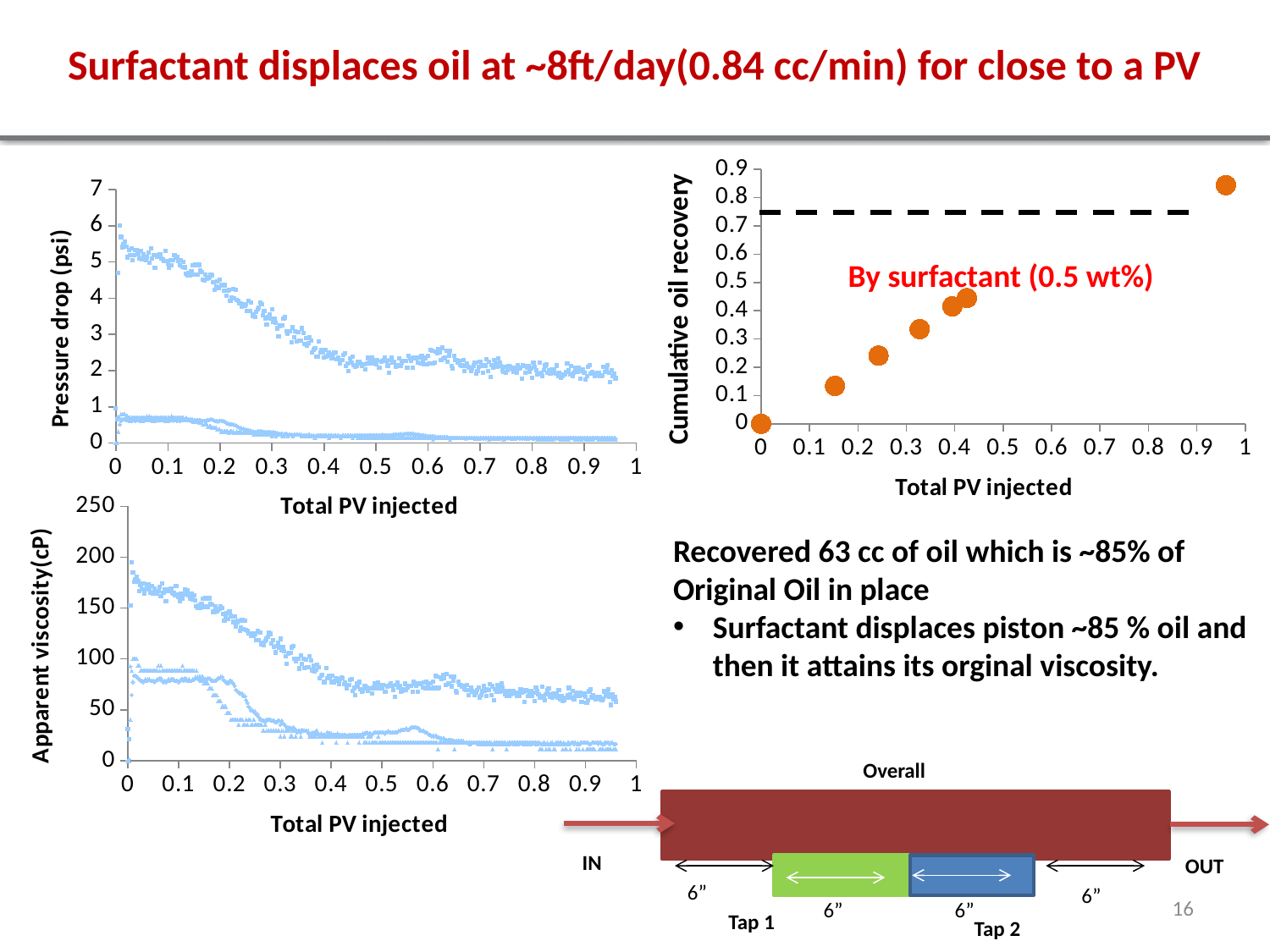
In the apparent viscosity chart (bottom left), is the lower series value at 0.9 PV injected greater or less than 50? less In the cumulative oil recovery chart (top right), is the highest plotted cumulative oil recovery value greater or less than 0.8? greater In the cumulative oil recovery chart (top right), how many data points are plotted? 7 In the cumulative oil recovery chart (top right), do the values rise or fall as Total PV injected increases? rise In the cumulative oil recovery chart (top right), is the cumulative oil recovery at about 0.15 PV injected greater or less than 0.2? less What kind of chart is the pressure drop chart (top left)? scatter chart In the pressure drop chart (top left), does the upper series rise or fall as Total PV injected increases? fall What is the y-axis title of the apparent viscosity chart (bottom left)? Apparent viscosity(cP) In the cumulative oil recovery chart (top right), what label is written in red on the plot area? By surfactant (0.5 wt%)